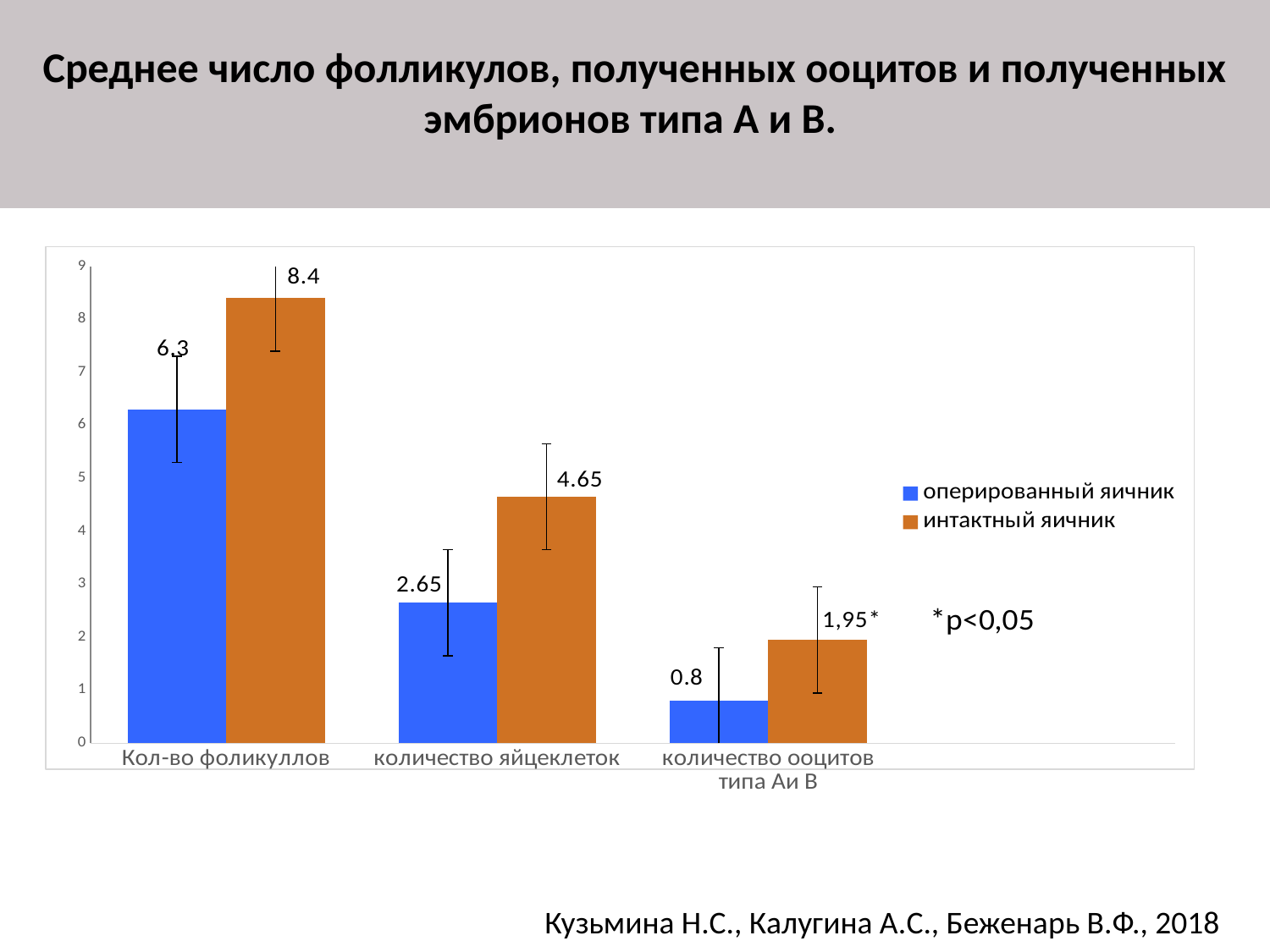
Which category has the highest value for "оперированный яичник"? Кол-во фоликуллов What type of chart is shown on the slide? bar chart Which colour represents "оперированный яичник" in the chart? blue What is the value for "оперированный яичник" in the "количество яйцеклеток" category? 2.65 What is the value for "оперированный яичник" in the "количество ооцитов типа Аи В" category? 0.8 What is the value for "интактный яичник" in the "количество яйцеклеток" category? 4.65 What is the difference between the "интактный яичник" and "оперированный яичник" values in the "Кол-во фоликуллов" category? 2.1 How many series does the legend list? 2 Which category has the lowest value for "интактный яичник"? количество ооцитов типа Аи В In the "количество яйцеклеток" category, which series has the larger value? интактный яичник What is the value for "интактный яичник" in the "Кол-во фоликуллов" category? 8.4 How many categories are shown on the x axis? 3